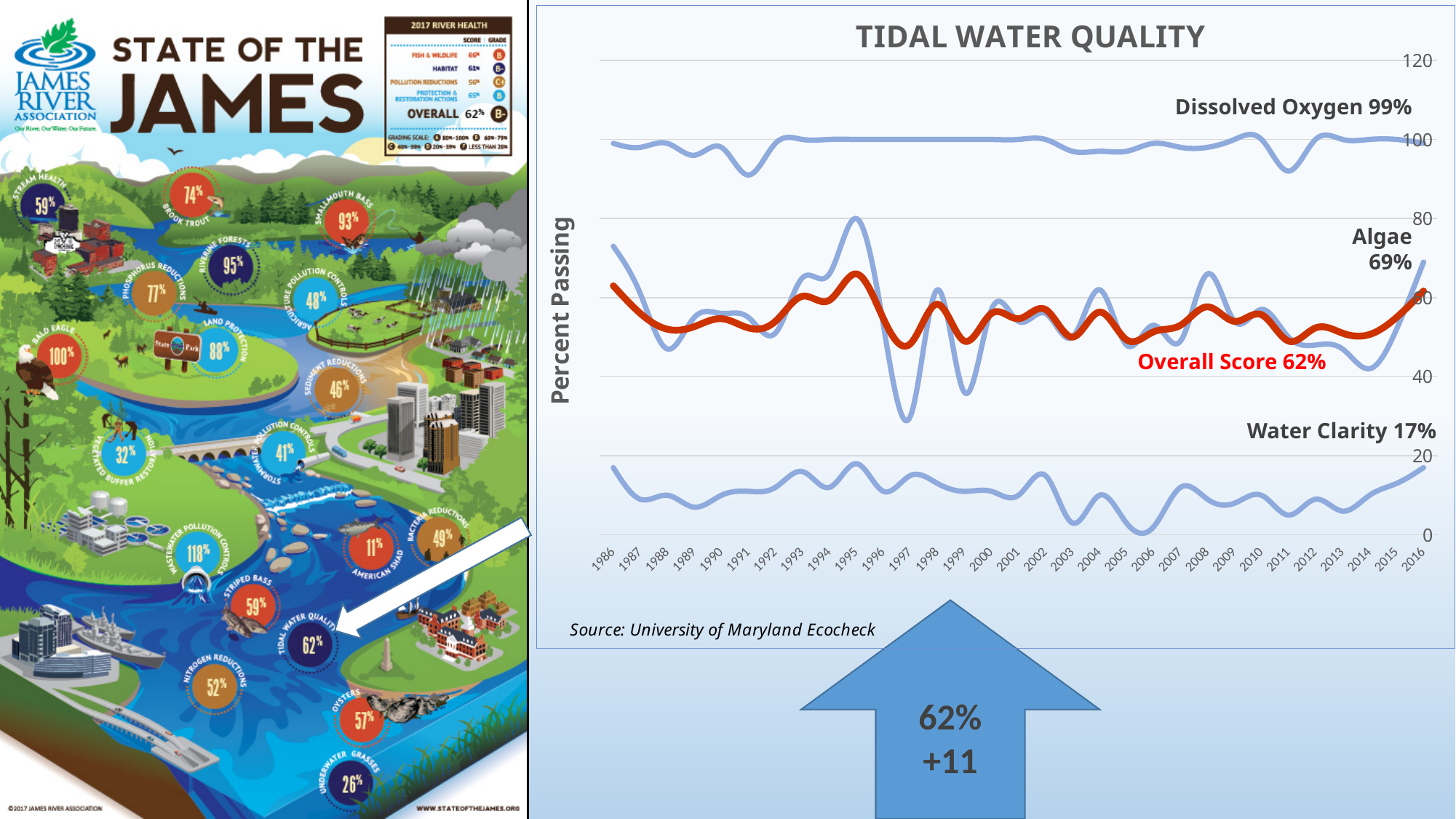
In the Tidal Water Quality chart, what value is labelled for Dissolved Oxygen? 99% In the Tidal Water Quality chart, what is the difference between the labelled Dissolved Oxygen value and the labelled Water Clarity value? 82 percentage points What is the label on the vertical axis of the Tidal Water Quality chart? Percent Passing In the Tidal Water Quality chart, is the Water Clarity value for 2006 greater or less than 20? less In the Tidal Water Quality chart, which is larger: the labelled Algae value or the labelled Overall Score? Algae In the Tidal Water Quality chart, what is the labelled Overall Score? 62% What is the title of the chart on the right side of the slide? TIDAL WATER QUALITY What kind of chart is the Tidal Water Quality chart? line chart In the Tidal Water Quality chart, what value is labelled for Water Clarity? 17% In the Tidal Water Quality chart, which labelled series has the lowest value? Water Clarity In the Tidal Water Quality chart, which labelled series has the highest value? Dissolved Oxygen In the Tidal Water Quality chart, what value is labelled for Algae? 69%